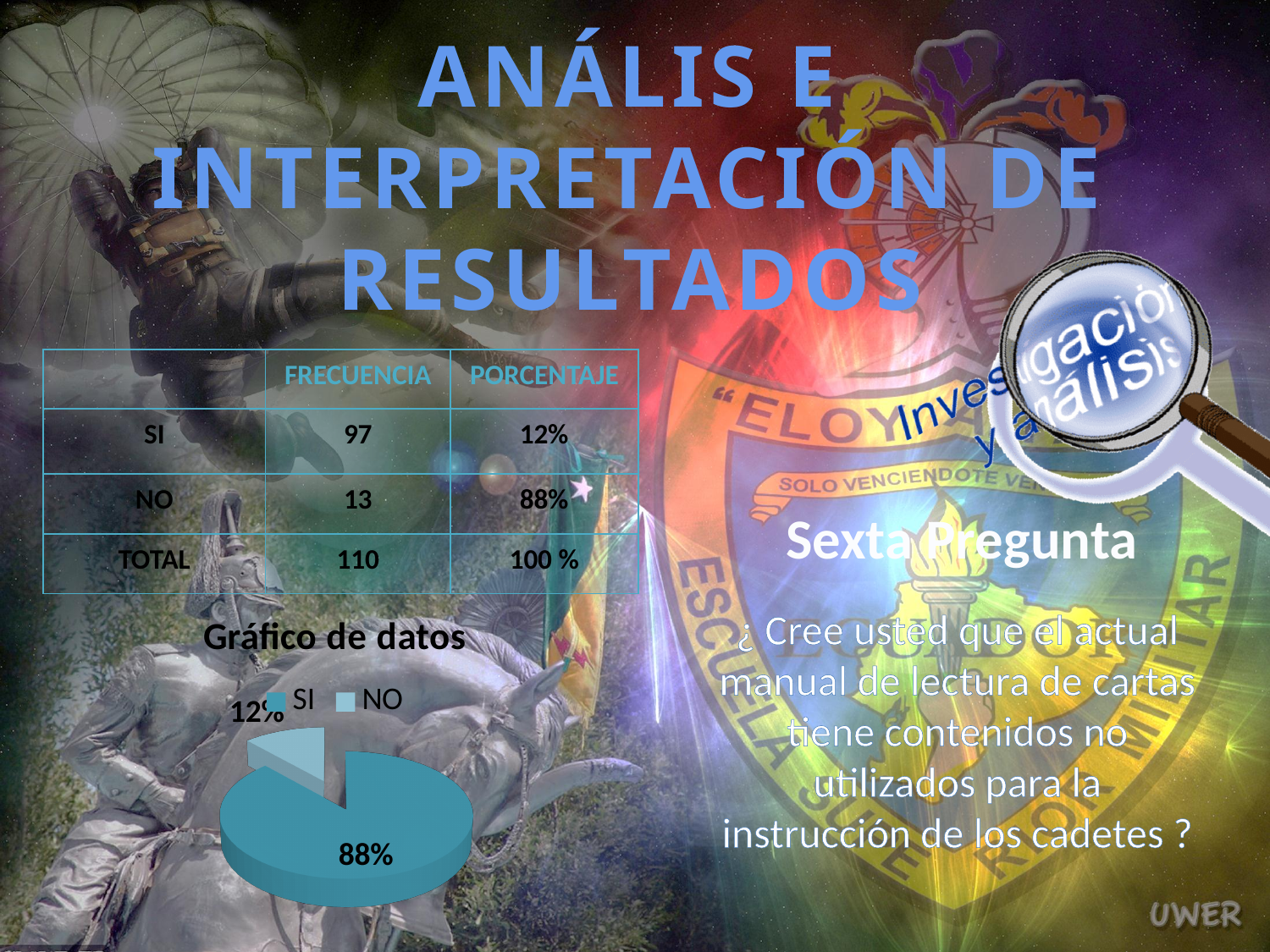
What percentage is shown on the smallest slice of the pie chart? 12% What is the title shown above the pie chart? Gráfico de datos How many entries does the pie chart's legend list? 2 How many slices does the pie chart have? 2 By how many percentage points does the larger slice of the pie chart exceed the smaller slice? 76 Is the smallest slice of the pie chart greater or less than 25%? less What kind of chart is shown under the heading "Gráfico de datos"? pie chart What are the two entries in the pie chart's legend? SI and NO What do the two slice labels on the pie chart add up to? 100% Is the largest slice of the pie chart greater or less than 50%? greater What percentage is shown on the largest slice of the pie chart? 88%